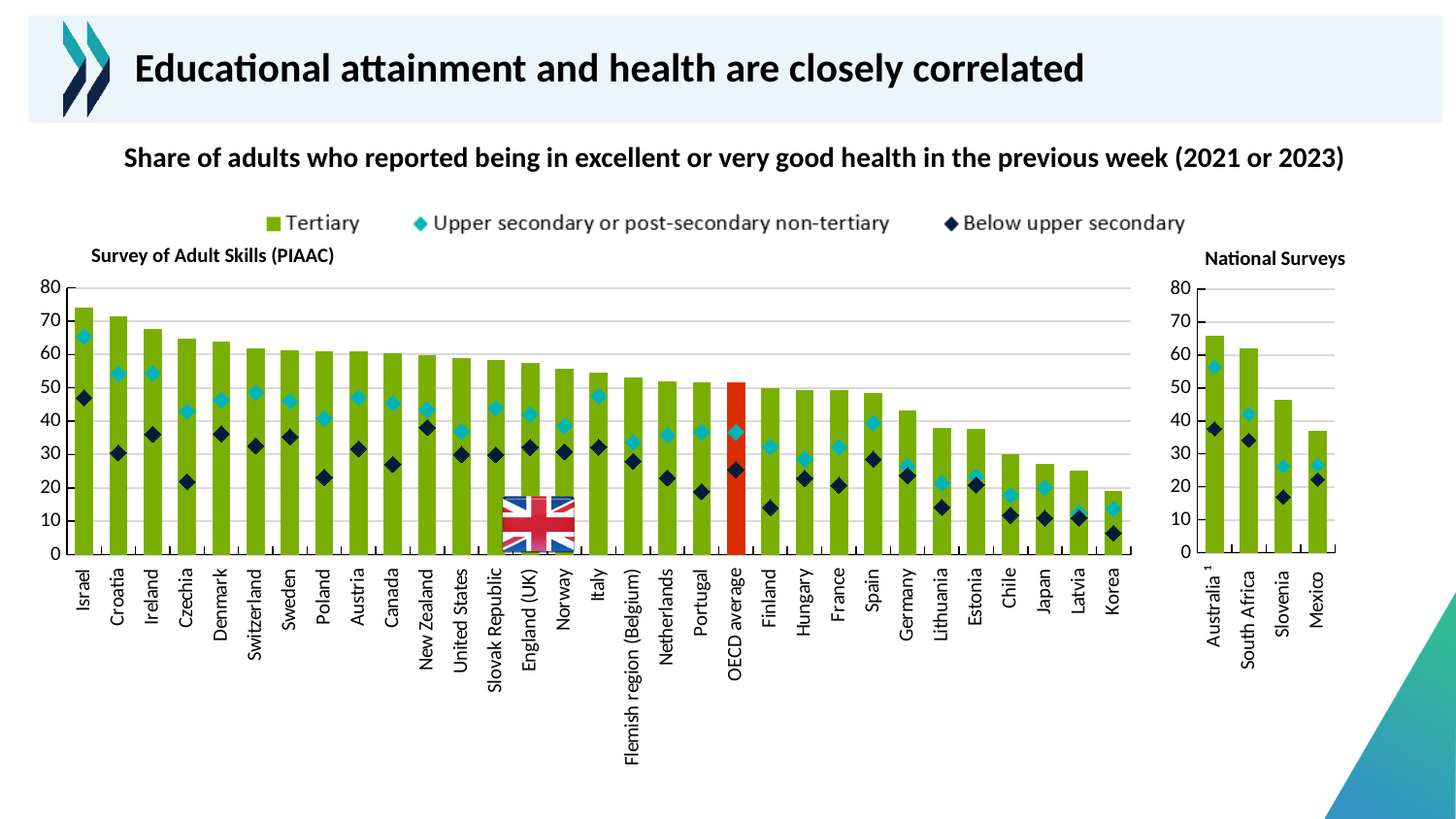
How many series does the legend list? 3 In the Survey of Adult Skills (PIAAC) chart, is the Tertiary value for Israel greater or less than 70? greater In the Survey of Adult Skills (PIAAC) chart, do the Tertiary bars rise or fall from left to right? fall In the Survey of Adult Skills (PIAAC) chart, which country has the highest Tertiary value? Israel In the Survey of Adult Skills (PIAAC) chart, which bar is coloured red instead of green? OECD average How many countries are shown in the National Surveys chart? 4 In the National Surveys chart, which country has the highest Tertiary value? Australia In the Survey of Adult Skills (PIAAC) chart, which country has the lowest Tertiary value? Korea In the Survey of Adult Skills (PIAAC) chart, is the Tertiary value for Japan greater or less than 30? less In the National Surveys chart, is the Tertiary value for Australia greater or less than 60? greater In the National Surveys chart, which country has the lowest Tertiary value? Mexico